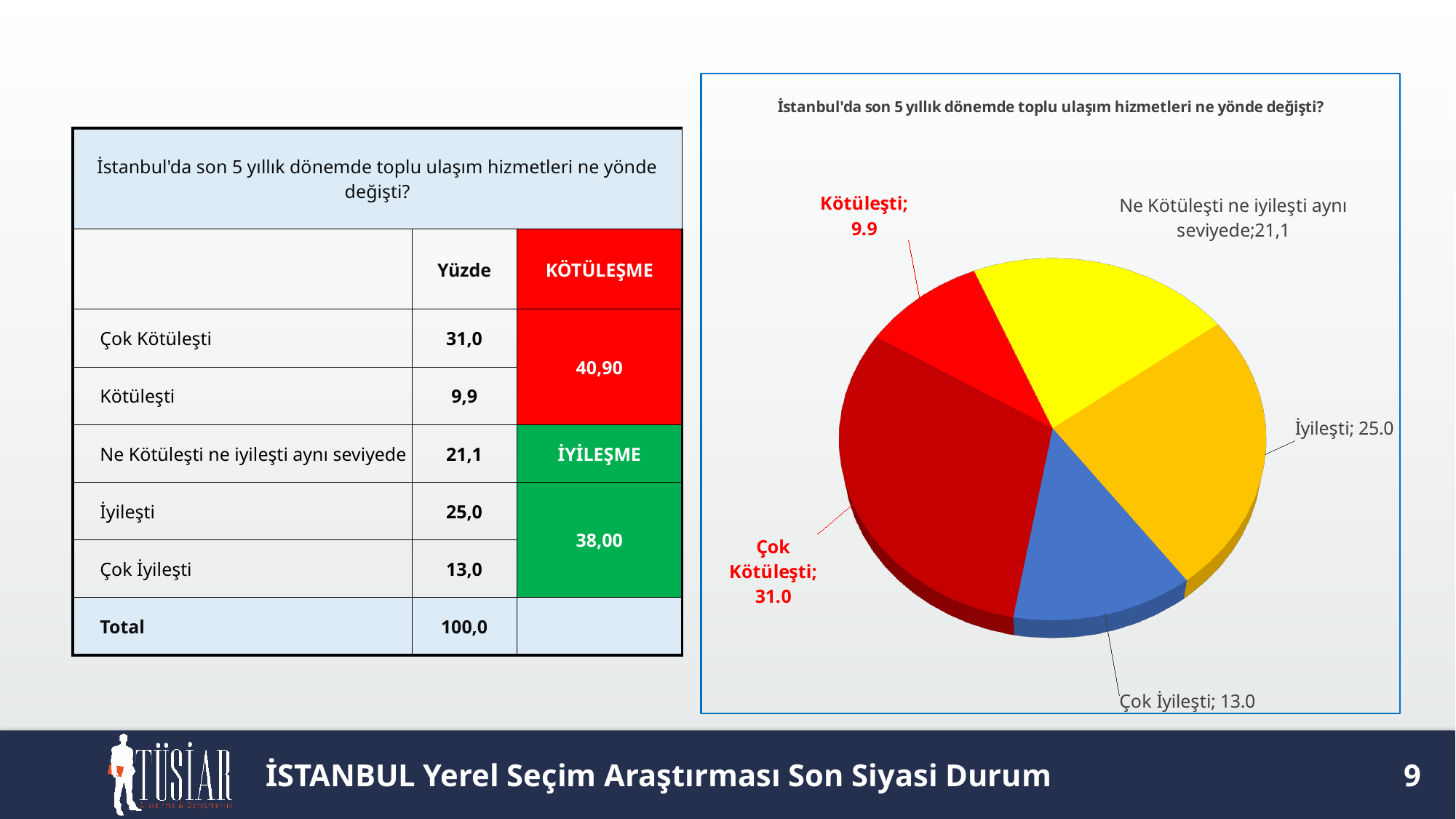
What is the value for Ne Kötüleşti ne iyileşti aynı seviyede in the pie chart? 21,1 What is the value for İyileşti in the pie chart? 25.0 Which is larger in the pie chart, İyileşti or Çok İyileşti? İyileşti How many slices does the pie chart have? 5 What is the difference between the values for Çok Kötüleşti and Çok İyileşti in the pie chart? 18.0 What is the value for Kötüleşti in the pie chart? 9.9 Which category has the largest slice in the pie chart? Çok Kötüleşti What is the value for Çok İyileşti in the pie chart? 13.0 Which category has the smallest slice in the pie chart? Kötüleşti What kind of chart is shown on the slide? pie chart What is the value for Çok Kötüleşti in the pie chart? 31.0 What is the title of the pie chart? İstanbul'da son 5 yıllık dönemde toplu ulaşım hizmetleri ne yönde değişti?